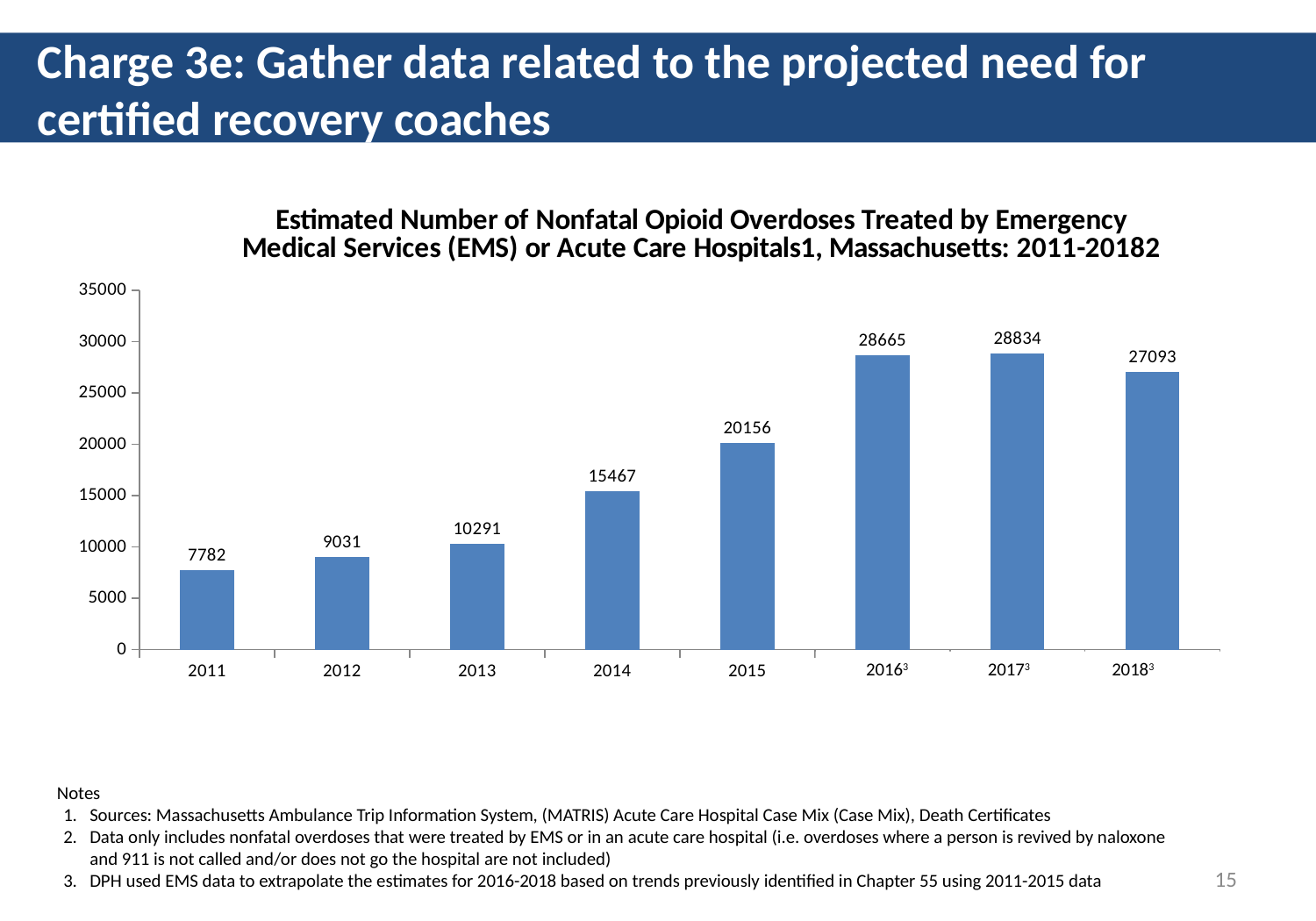
How many years are shown on the x axis? 8 Is the value for 2012 greater or less than 10000? less Which year has the lowest estimated number of nonfatal opioid overdoses? 2011 What is the difference between the values for 2017 and 2016? 169 What is the estimated number of nonfatal opioid overdoses for 2018? 27093 Which is larger, the value for 2016 or the value for 2018? 2016 What kind of chart is shown on the slide? bar chart What is the estimated number of nonfatal opioid overdoses for 2015? 20156 What is the difference between the values for 2014 and 2013? 5176 What is the estimated number of nonfatal opioid overdoses for 2011? 7782 Do the values generally rise or fall from 2011 to 2017? rise Which year has the highest estimated number of nonfatal opioid overdoses? 2017